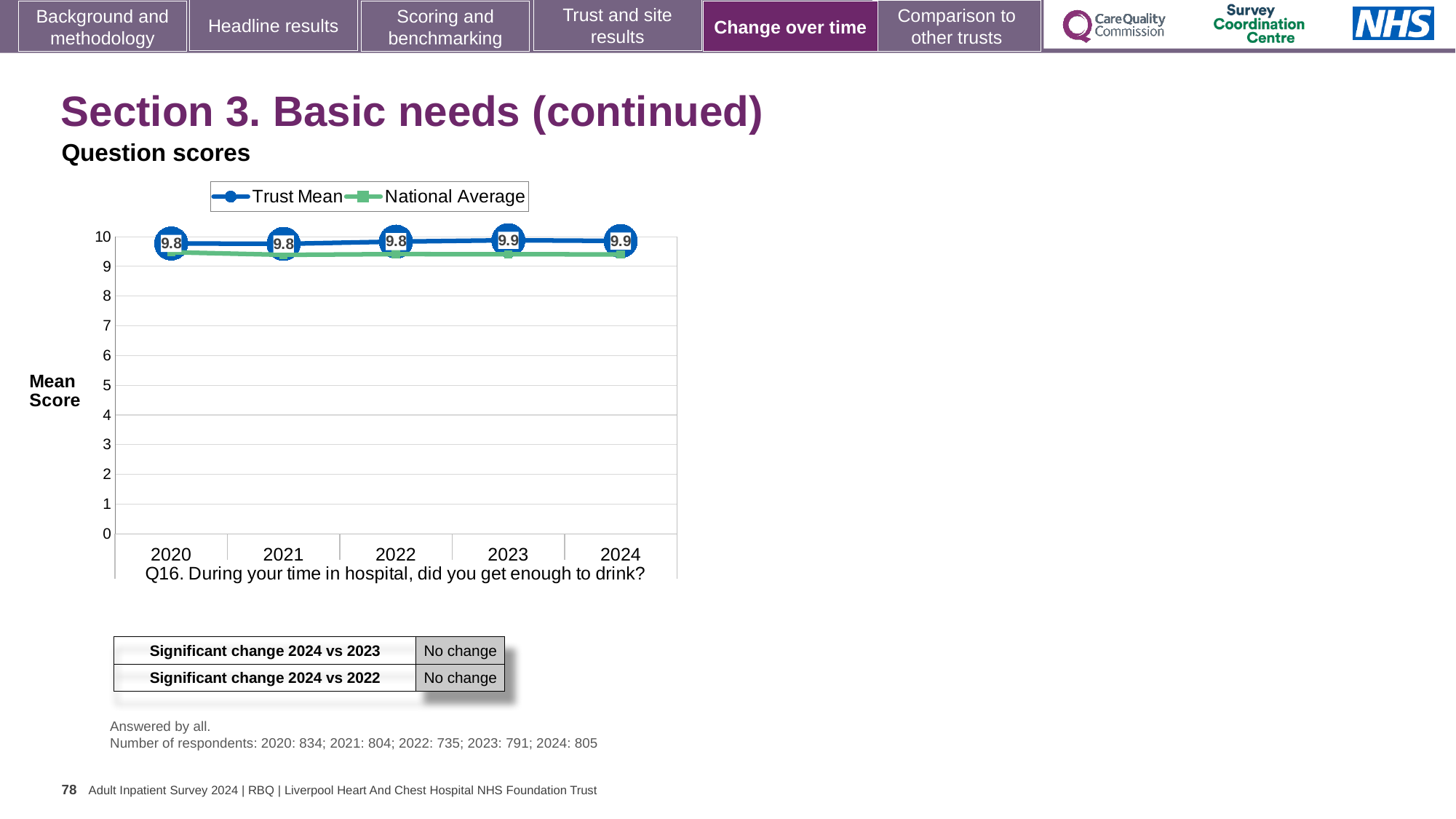
What is the difference between the Trust Mean score in 2024 and in 2020? 0.1 Is the National Average value for 2020 greater or less than 8? greater What is the Trust Mean score for 2024? 9.9 What is the label on the y axis of the chart? Mean Score In 2024, which is higher: the Trust Mean or the National Average? Trust Mean What is the Trust Mean score for 2020? 9.8 How many series does the chart legend list? 2 Does the Trust Mean score rise or fall from 2020 to 2024? Rise What kind of chart is shown on the slide? Line chart What is the Trust Mean score for 2022? 9.8 Is the National Average value for 2024 greater or less than 9? greater How many years are shown on the x axis of the chart? 5